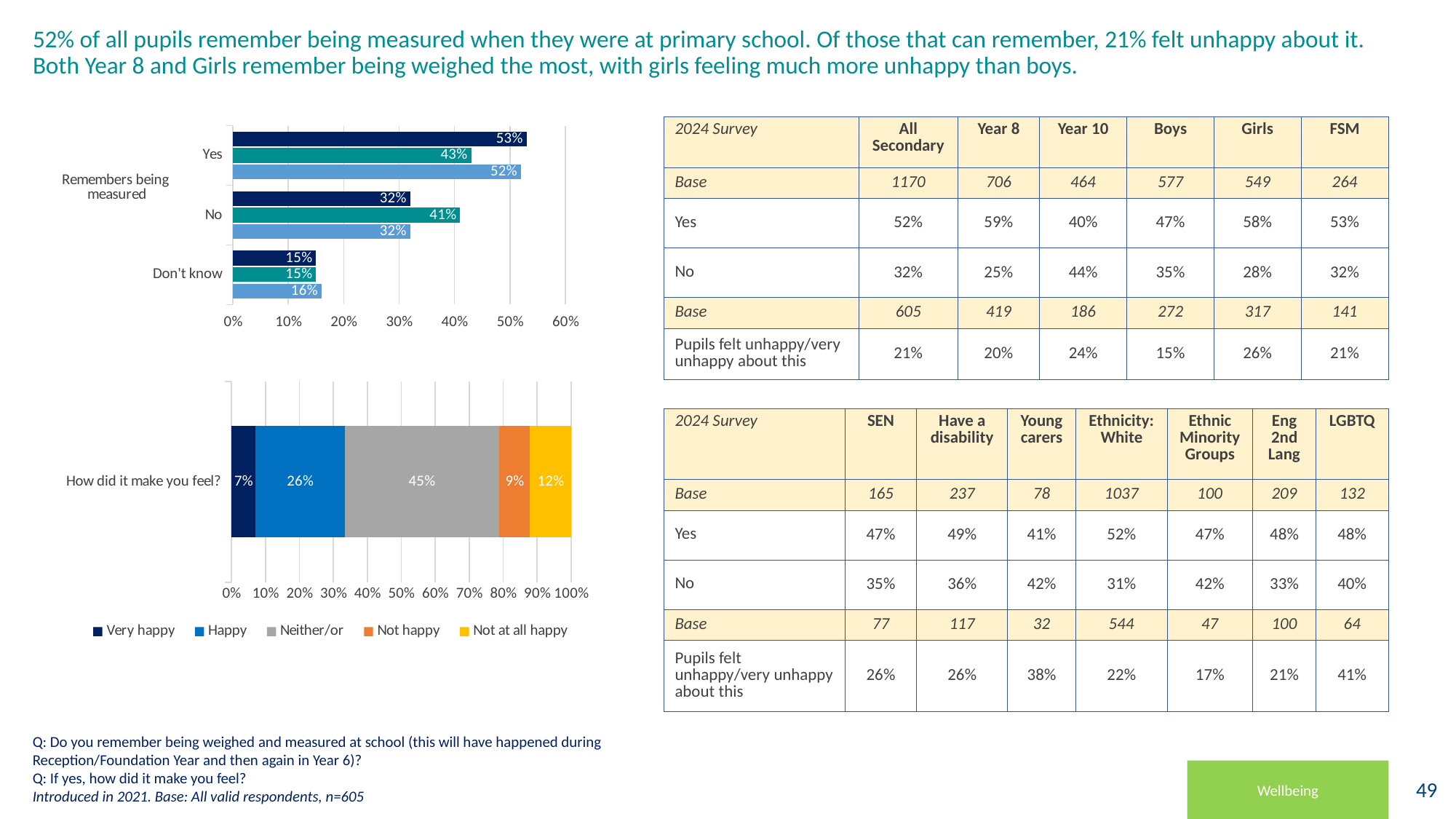
In the bottom-left chart 'How did it make you feel?', which response has the largest share of the bar? Neither/or In the top-left chart 'Remembers being measured', is the light blue bar for 'Yes' larger or smaller than the light blue bar for 'No'? Larger In the top-left chart 'Remembers being measured', what value is shown on the middle (teal) bar for 'No'? 41% In the bottom-left chart 'How did it make you feel?', what percentage is shown for 'Neither/or'? 45% What kind of chart is the bottom-left chart 'How did it make you feel?'? Stacked bar chart How many series does the legend of the bottom-left chart 'How did it make you feel?' list? 5 In the bottom-left chart 'How did it make you feel?', which response has the smallest share of the bar? Very happy In the top-left chart 'Remembers being measured', what value is shown on the top (dark navy) bar for 'Yes'? 53% In the bottom-left chart 'How did it make you feel?', what is the difference between the 'Happy' and 'Not happy' percentages? 17% How many response categories are shown on the top-left chart 'Remembers being measured'? 3 In the bottom-left chart 'How did it make you feel?', what percentage is shown for 'Not at all happy'? 12% In the bottom-left chart 'How did it make you feel?', what percentage is shown for 'Very happy'? 7%